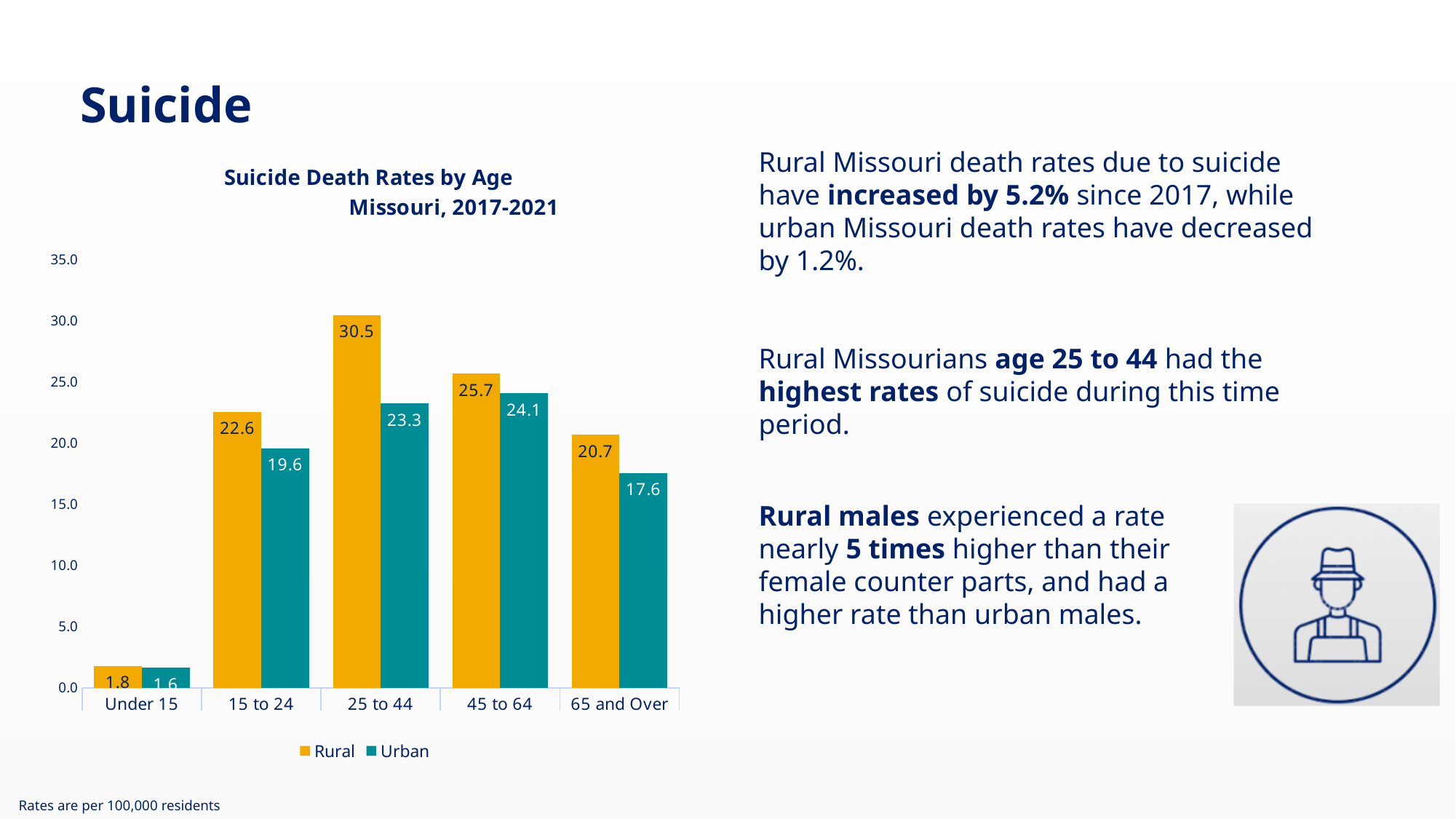
What is the Urban suicide death rate for the 15 to 24 age group? 19.6 What is the Rural suicide death rate for the 25 to 44 age group? 30.5 Which is larger, the Rural rate for 15 to 24 or the Urban rate for 45 to 64? Urban rate for 45 to 64 What kind of chart is shown on the slide? Bar chart What is the difference between the Rural rates for the 45 to 64 and 65 and Over age groups? 5.0 What is the Urban suicide death rate for the 65 and Over age group? 17.6 Which age group has the highest Rural suicide death rate? 25 to 44 What is the title of the chart? Suicide Death Rates by Age Missouri, 2017-2021 Which age group has the lowest Urban suicide death rate? Under 15 How many age groups are shown on the x axis of the chart? 5 What is the difference between the Rural and Urban rates for the 25 to 44 age group? 7.2 How many series does the chart legend list? 2